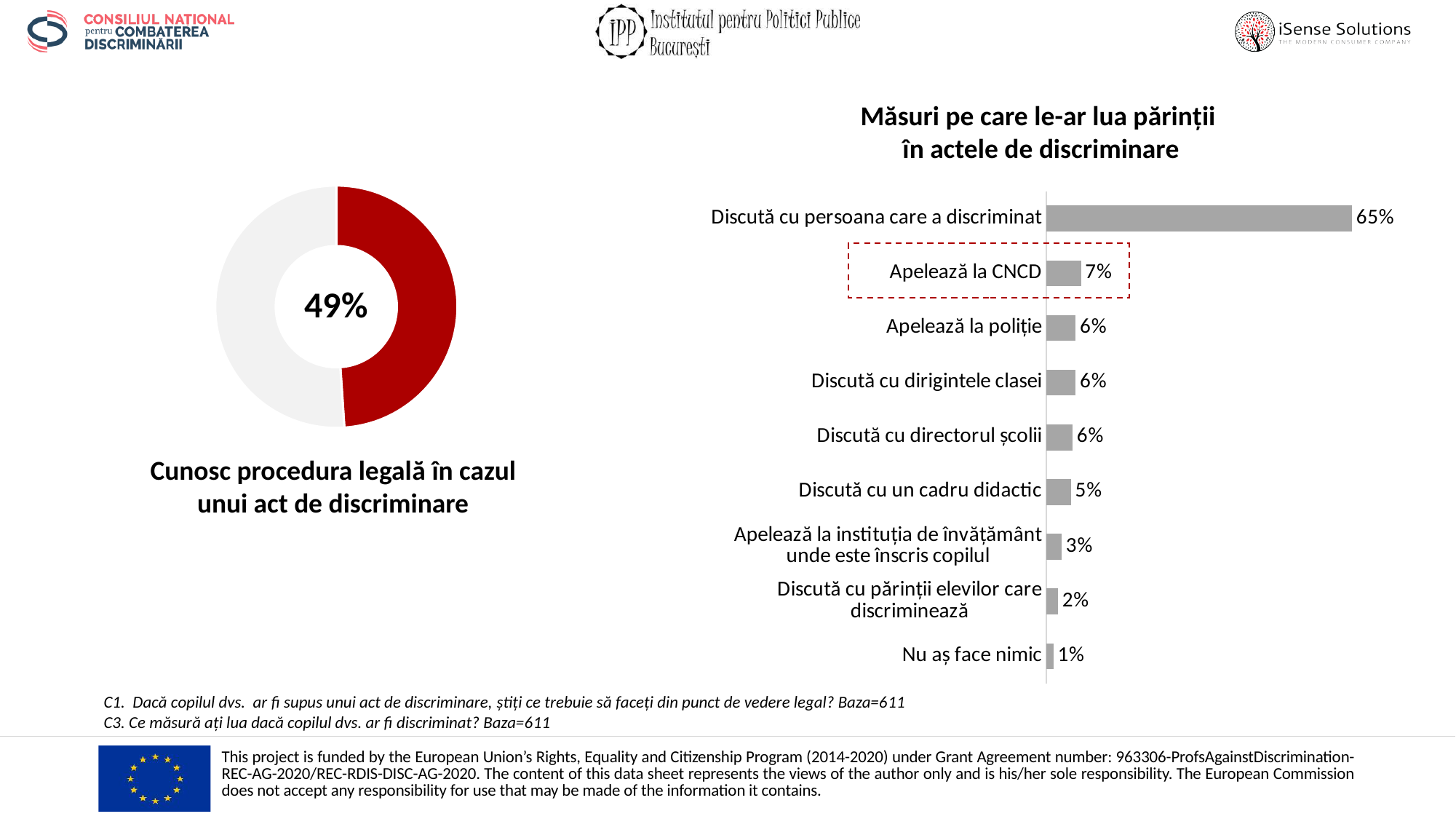
In the bar chart 'Măsuri pe care le-ar lua părinții în actele de discriminare', which is larger: 'Apelează la CNCD' or 'Discută cu un cadru didactic'? Apelează la CNCD What kind of chart is the chart on the left side of the slide? Donut chart In the donut chart on the left, what percentage is shown for 'Cunosc procedura legală în cazul unui act de discriminare'? 49% In the bar chart 'Măsuri pe care le-ar lua părinții în actele de discriminare', what is the difference between 'Discută cu persoana care a discriminat' and 'Apelează la CNCD'? 58% In the bar chart 'Măsuri pe care le-ar lua părinții în actele de discriminare', what is the value for 'Discută cu persoana care a discriminat'? 65% In the bar chart 'Măsuri pe care le-ar lua părinții în actele de discriminare', what is the value for 'Apelează la CNCD'? 7% In the bar chart 'Măsuri pe care le-ar lua părinții în actele de discriminare', which category has the lowest value? Nu aș face nimic In the bar chart 'Măsuri pe care le-ar lua părinții în actele de discriminare', which category is highlighted with a red dashed box? Apelează la CNCD In the bar chart 'Măsuri pe care le-ar lua părinții în actele de discriminare', what is the value for 'Nu aș face nimic'? 1% How many categories are shown in the bar chart 'Măsuri pe care le-ar lua părinții în actele de discriminare'? 9 What kind of chart is the chart on the right side of the slide? Bar chart In the bar chart 'Măsuri pe care le-ar lua părinții în actele de discriminare', which category has the highest value? Discută cu persoana care a discriminat